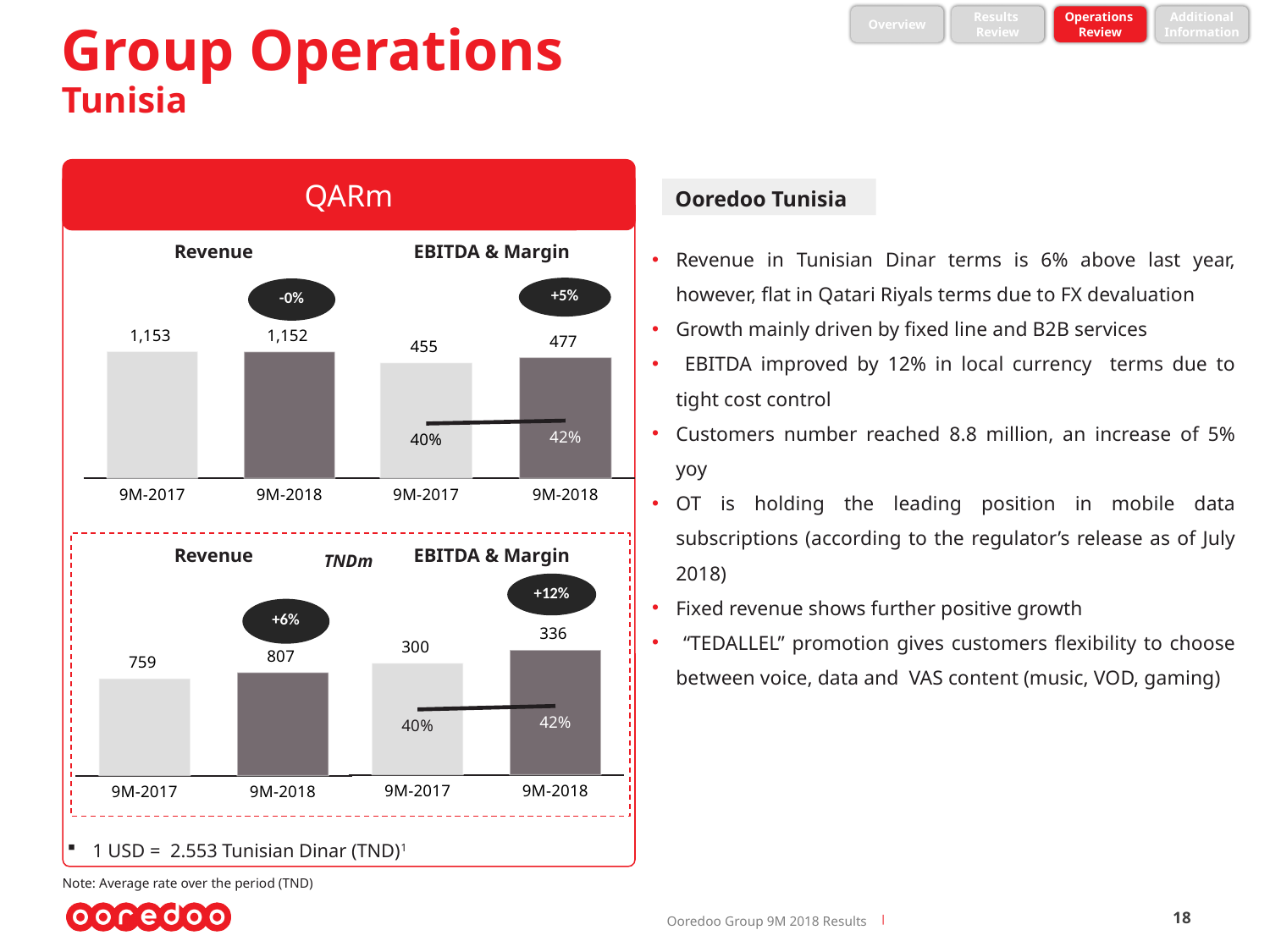
In the TNDm Revenue chart, what is the difference in revenue between 9M-2018 and 9M-2017? 48 In the TNDm EBITDA & Margin chart, which period has the higher EBITDA, 9M-2017 or 9M-2018? 9M-2018 In the QARm Revenue chart, what is the revenue for 9M-2018? 1,152 In the TNDm Revenue chart, what is the revenue for 9M-2018? 807 In the TNDm EBITDA & Margin chart, what is the EBITDA margin for 9M-2018? 42% In the QARm EBITDA & Margin chart, what is the EBITDA margin for 9M-2017? 40% What type of chart is the QARm Revenue chart? Bar chart In the TNDm EBITDA & Margin chart, what is the EBITDA for 9M-2017? 300 In the QARm EBITDA & Margin chart, what is the EBITDA for 9M-2018? 477 In the QARm Revenue chart, what is the revenue for 9M-2017? 1,153 In the QARm EBITDA & Margin chart, what is the difference in EBITDA between 9M-2018 and 9M-2017? 22 What percentage change is shown in the bubble above the TNDm Revenue chart? +6%